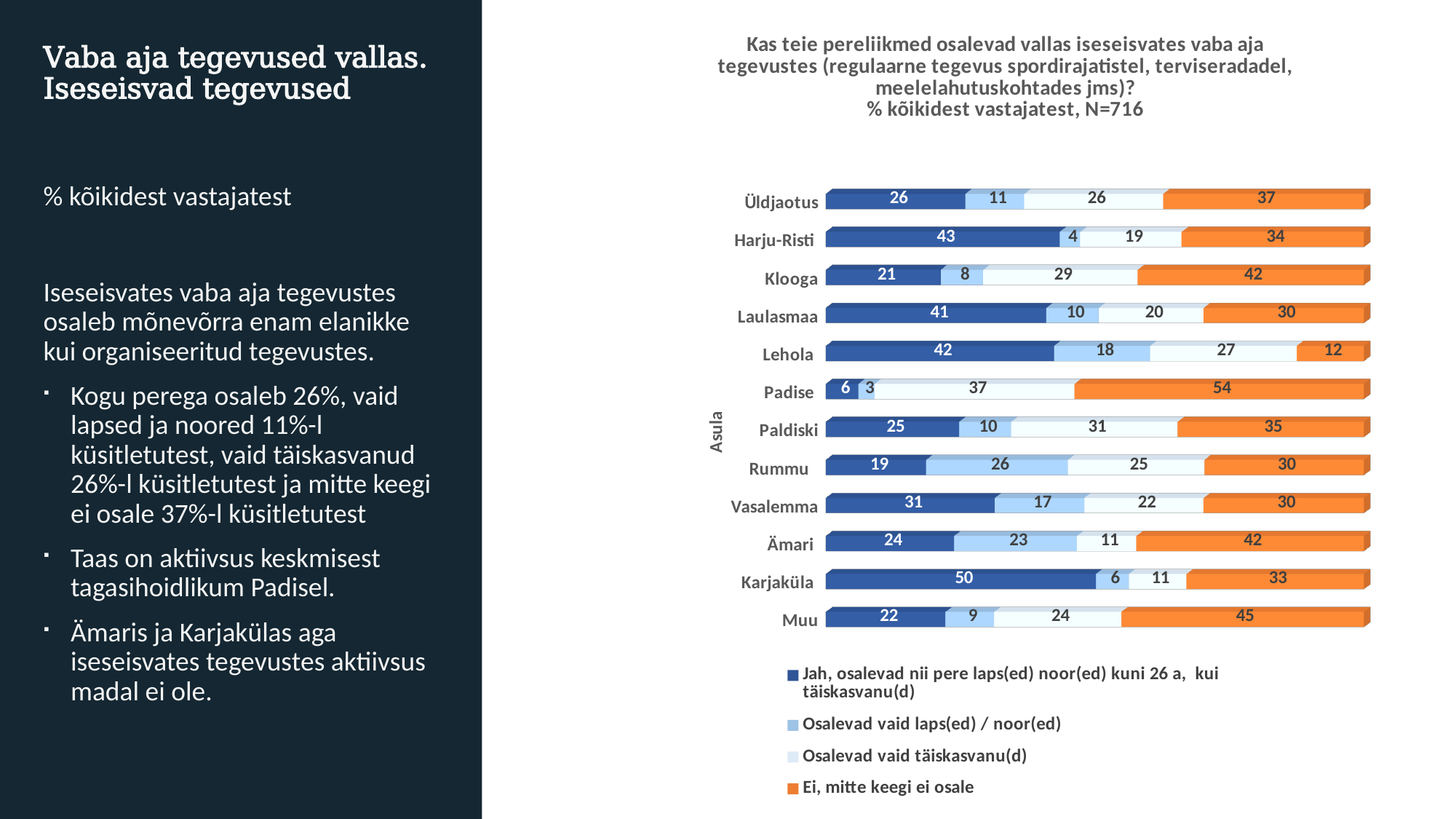
Which category has the highest value in the "Ei, mitte keegi ei osale" series? Padise How many series does the legend list? 4 What is the value for Padise in the "Ei, mitte keegi ei osale" series? 54 How many categories (asula) are shown on the chart? 12 What is the value for Üldjaotus in the "Osalevad vaid täiskasvanu(d)" series? 26 Which category has the lowest value in the "Ei, mitte keegi ei osale" series? Lehola What kind of chart is shown on the slide? Stacked bar chart What is the difference between the "Ei, mitte keegi ei osale" values for Muu and Klooga? 3 What is the total of the stacked bar for Padise? 100 Which is larger in the "Jah, osalevad nii pere laps(ed) noor(ed) kuni 26 a, kui täiskasvanu(d)" series: Harju-Risti or Laulasmaa? Harju-Risti What is the value for Karjaküla in the "Jah, osalevad nii pere laps(ed) noor(ed) kuni 26 a, kui täiskasvanu(d)" series? 50 What is the value for Rummu in the "Osalevad vaid laps(ed) / noor(ed)" series? 26